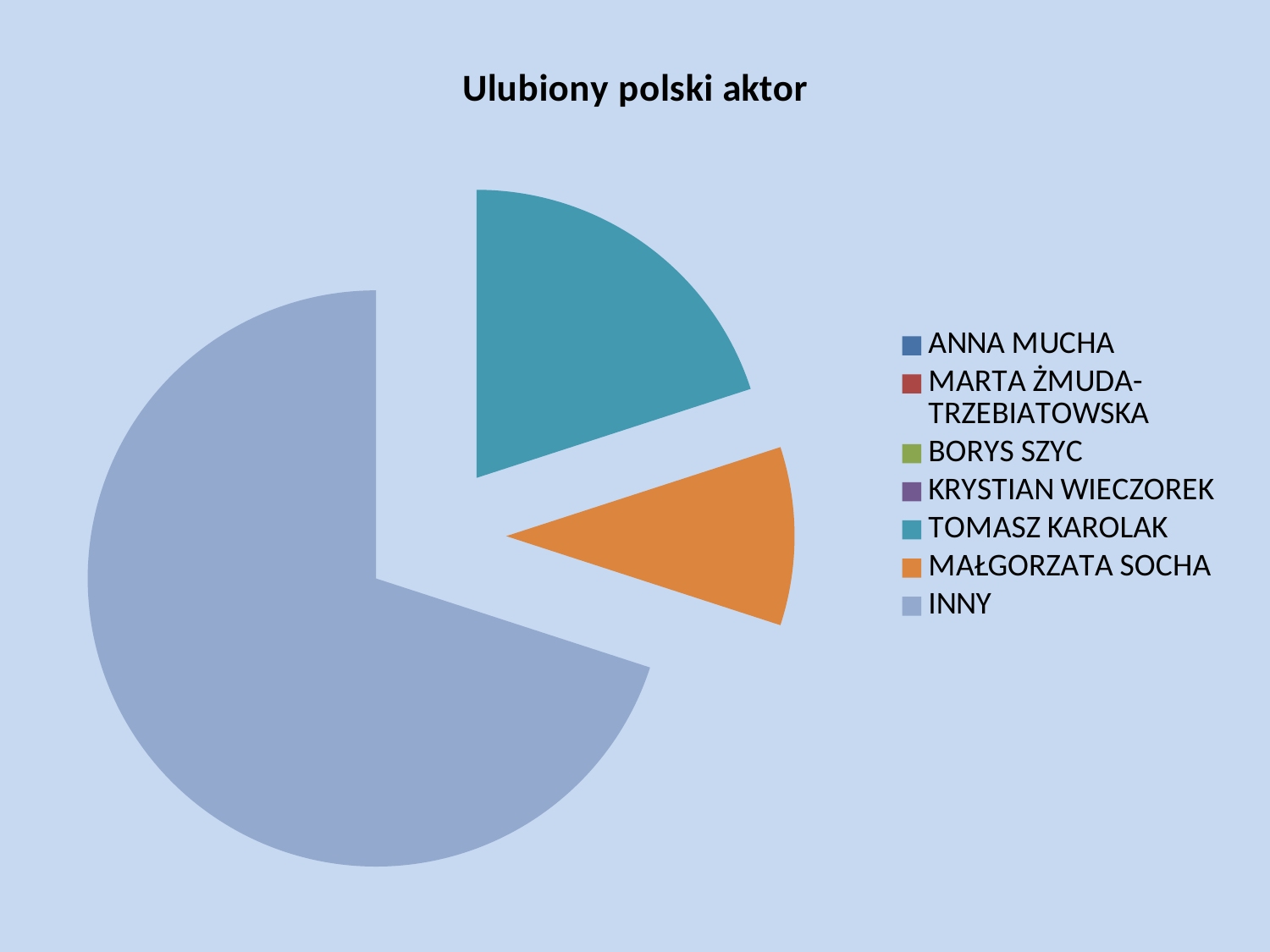
Which legend entry is shown in orange? MAŁGORZATA SOCHA What is the title of the chart? Ulubiony polski aktor Which slice is larger, TOMASZ KAROLAK or MAŁGORZATA SOCHA? TOMASZ KAROLAK How many entries does the chart's legend list? 7 Which slice is larger, INNY or TOMASZ KAROLAK? INNY Does the INNY slice take up more or less than half of the pie? more Which of the visible slices is the smallest? MAŁGORZATA SOCHA Which category has the largest slice of the pie? INNY What kind of chart is shown on the slide? pie chart How many slices are visible in the pie? 3